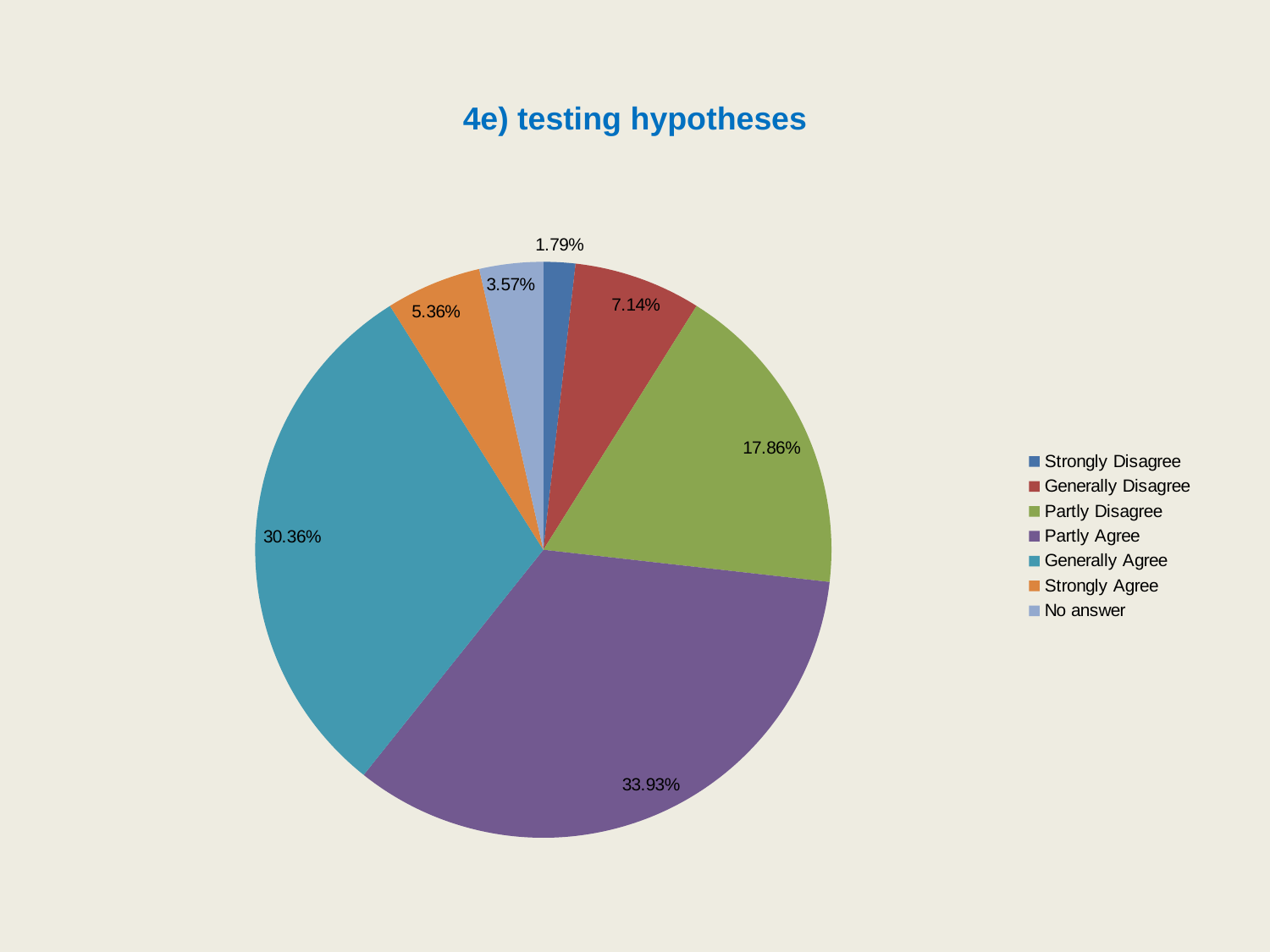
How many categories does the legend list? 7 Which category has the smallest slice? Strongly Disagree What share of the pie is No answer? 3.57% What share of the pie is Strongly Disagree? 1.79% What share of the pie is Partly Disagree? 17.86% What is the title of the chart? 4e) testing hypotheses What share of the pie is Partly Agree? 33.93% Which category has the largest slice? Partly Agree What kind of chart is shown on the slide? pie chart What share of the pie is Generally Agree? 30.36% What is the difference between the Partly Agree and Generally Agree shares? 3.57% Which is larger, Generally Disagree or Strongly Agree? Generally Disagree